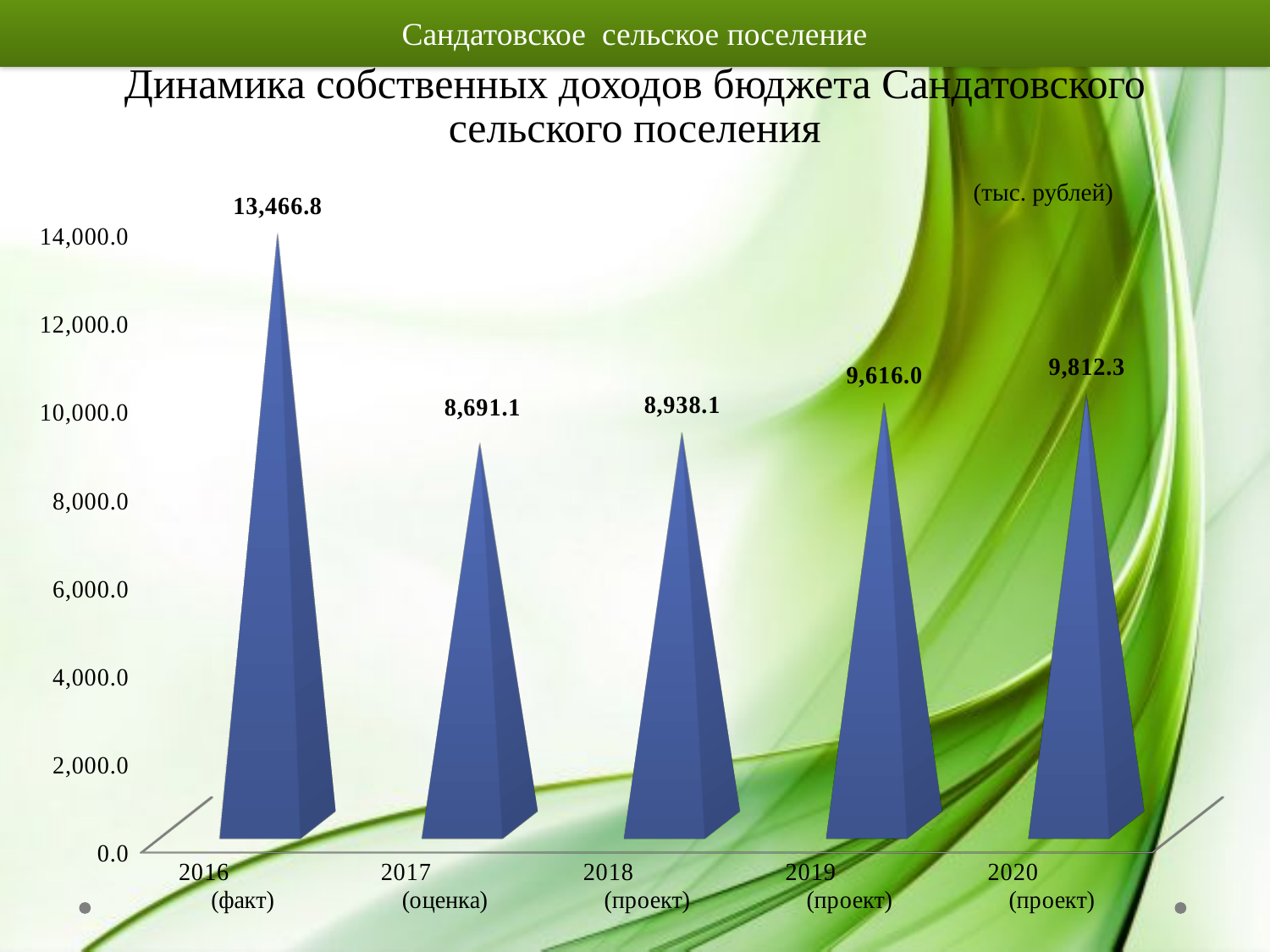
What is the difference between the values for 2020 (проект) and 2019 (проект)? 196.3 Is the value for 2017 (оценка) greater or less than 10,000.0? less What is the value for 2018 (проект)? 8,938.1 What kind of chart is shown on the slide? bar chart What is the value for 2020 (проект)? 9,812.3 Do the values rise or fall from 2017 (оценка) to 2020 (проект)? rise Which year has the lowest value? 2017 (оценка) What is the difference between the values for 2016 (факт) and 2017 (оценка)? 4,775.7 What is the value for 2016 (факт)? 13,466.8 How many years are shown on the x axis? 5 Which is larger, the value for 2018 (проект) or the value for 2019 (проект)? 2019 (проект) Which year has the highest value? 2016 (факт)